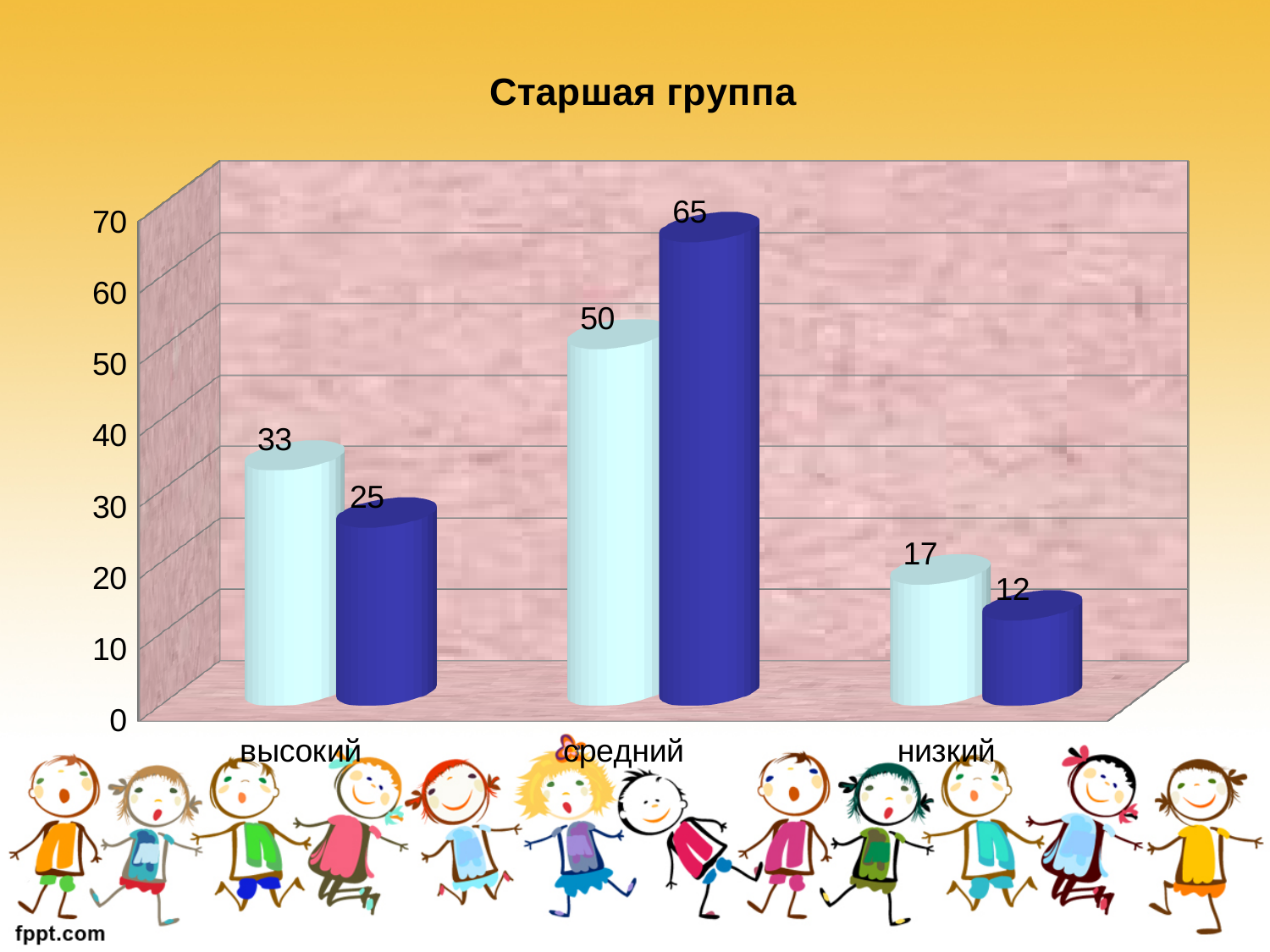
What kind of chart is shown on the slide? bar chart What is the title of the chart? Старшая группа Is the value of the light blue bar for "низкий" greater or less than 20? less What is the difference between the dark blue and light blue bars for "средний"? 15 Which category has the lowest light blue bar? низкий What is the value of the dark blue bar for "средний"? 65 Which category has the highest dark blue bar? средний How many categories are shown on the x axis of the chart? 3 What is the value of the light blue bar for "высокий"? 33 What is the value of the light blue bar for "средний"? 50 For "высокий", which bar is larger: the light blue or the dark blue? light blue What is the value of the dark blue bar for "низкий"? 12